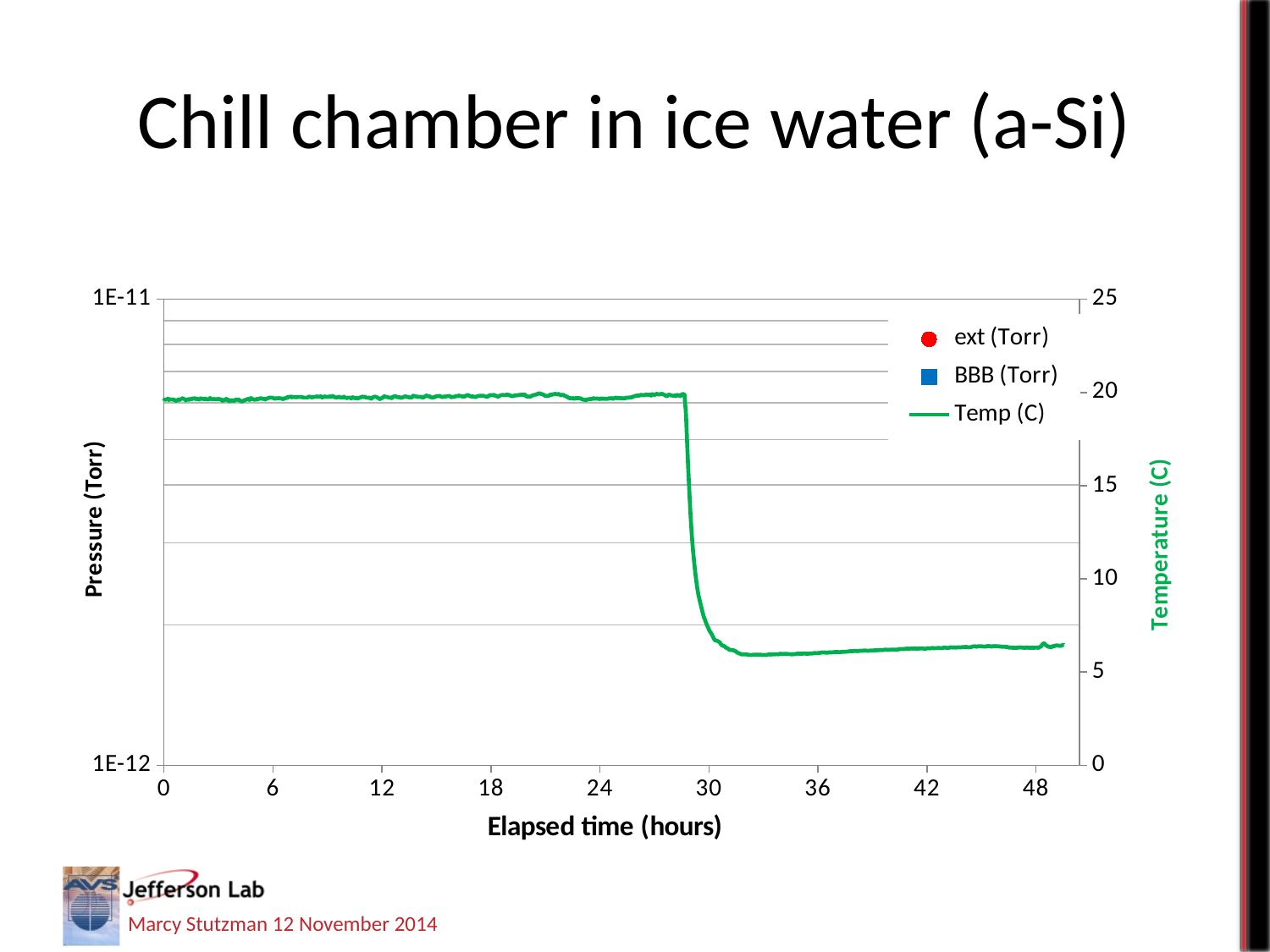
Is the Temp (C) value at 12 hours greater or less than 15? greater Is the Temp (C) value at 6 hours greater or less than 10? greater What is the label of the x axis? Elapsed time (hours) Is the Temp (C) value at 48 hours greater or less than 20? less How many series does the legend list? 3 Does the Temp (C) line rise or fall as elapsed time increases? fall What kind of chart is shown on the slide? line chart What is the title of the slide's chart? Chill chamber in ice water (a-Si)